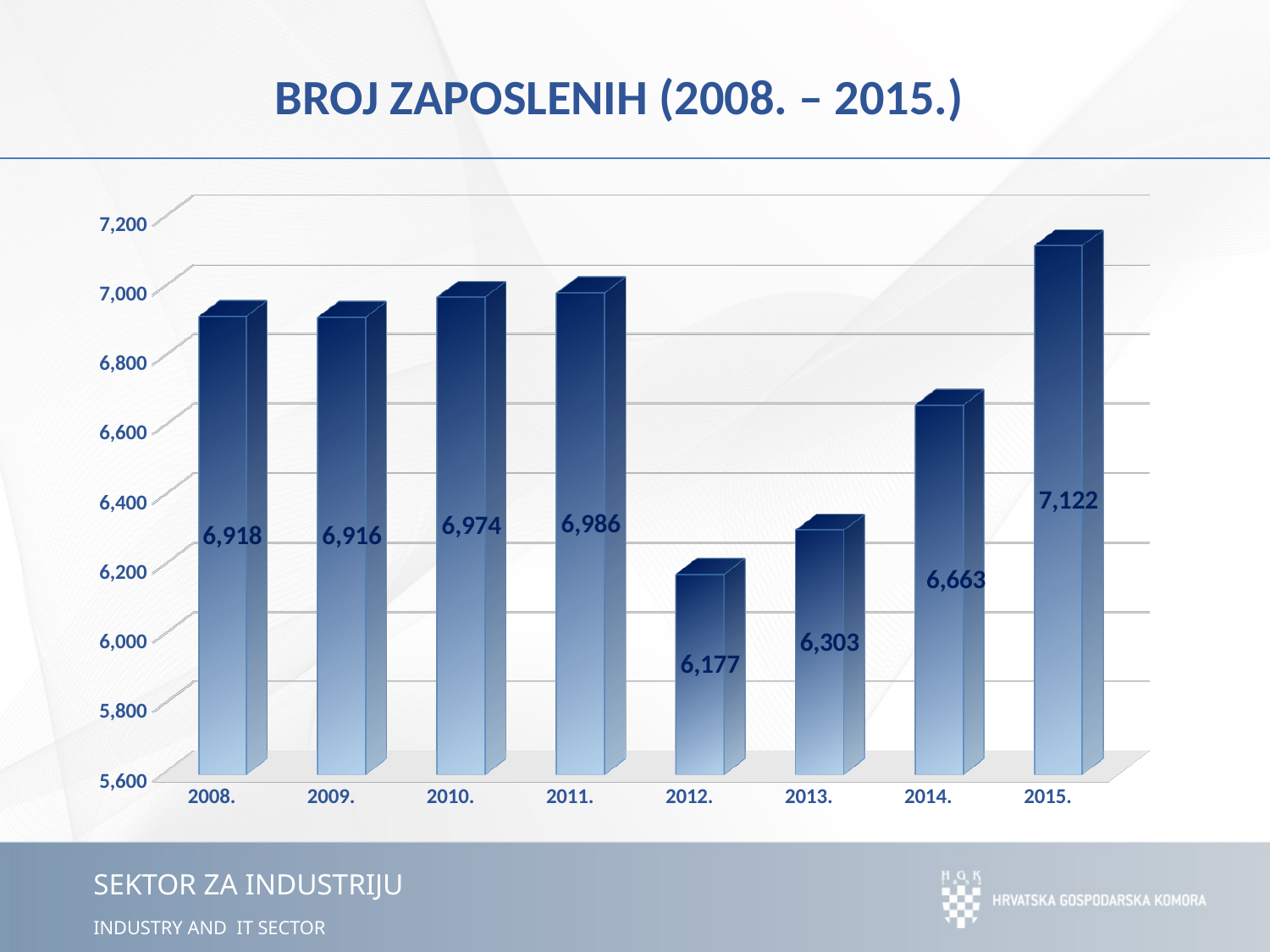
What is the value for 2015.? 7,122 What is the value for 2010.? 6,974 What is the difference between the values for 2015. and 2012.? 945 How many years are shown on the x axis? 8 What is the difference between the values for 2014. and 2013.? 360 What is the value for 2012.? 6,177 Is the value for 2013. greater or less than 6,400? less What is the title of the chart? BROJ ZAPOSLENIH (2008. – 2015.) What kind of chart is shown on the slide? bar chart Which is larger, the value for 2011. or the value for 2014.? 2011. Which year has the lowest value? 2012. Which year has the highest value? 2015.